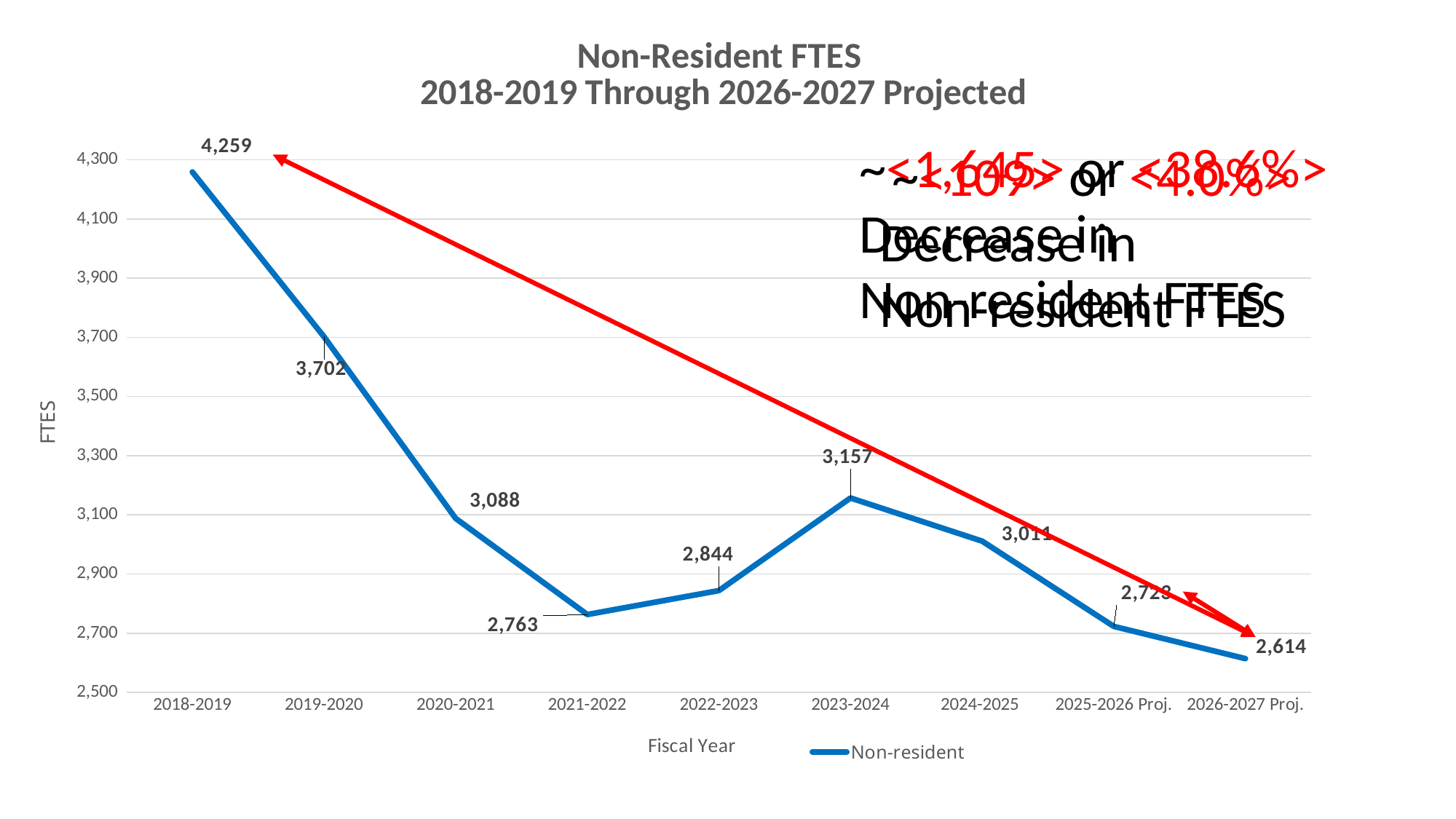
What is the Non-resident FTES value for 2026-2027 Proj.? 2,614 What kind of chart is shown on the slide? line chart Is the Non-resident FTES value for 2025-2026 Proj. greater or less than 2,900? less How many fiscal years are plotted on the x axis? 9 Which fiscal year has the highest Non-resident FTES value? 2018-2019 Which fiscal year has the lowest Non-resident FTES value? 2026-2027 Proj. What is the Non-resident FTES value for 2018-2019? 4,259 What is the Non-resident FTES value for 2023-2024? 3,157 What is the Non-resident FTES value for 2021-2022? 2,763 What is the difference between the Non-resident FTES values for 2018-2019 and 2026-2027 Proj.? 1,645 How many series does the legend list? 1 Which is larger, the Non-resident FTES value for 2022-2023 or for 2023-2024? 2023-2024